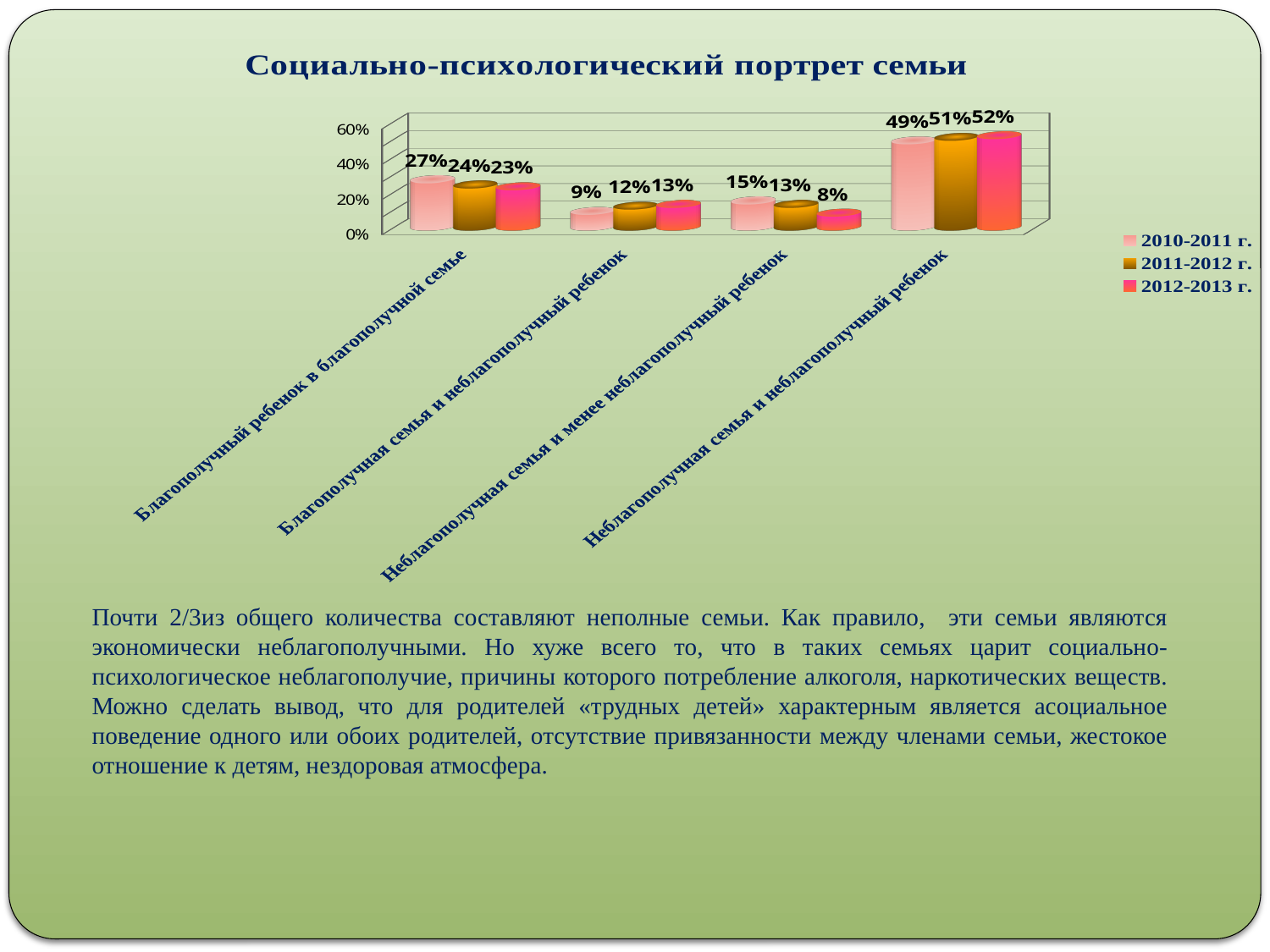
Which is larger for 'Благополучный ребенок в благополучной семье': the 2010-2011 г. value or the 2012-2013 г. value? 2010-2011 г. Do the values for 'Неблагополучная семья и неблагополучный ребенок' rise or fall from 2010-2011 г. to 2012-2013 г.? rise What is the difference between the 2010-2011 г. and 2012-2013 г. values for 'Неблагополучная семья и менее неблагополучный ребенок'? 7% What is the value for 2010-2011 г. in the category 'Благополучный ребенок в благополучной семье'? 27% What is the title of the slide containing the chart? Социально-психологический портрет семьи Which category has the lowest value for 2012-2013 г.? Неблагополучная семья и менее неблагополучный ребенок What is the value for 2012-2013 г. in the category 'Неблагополучная семья и неблагополучный ребенок'? 52% How many series does the legend list? 3 What kind of chart is shown on the slide? bar chart What is the value for 2011-2012 г. in the category 'Благополучная семья и неблагополучный ребенок'? 12% How many categories are shown on the x axis? 4 Which category has the highest value for 2012-2013 г.? Неблагополучная семья и неблагополучный ребенок